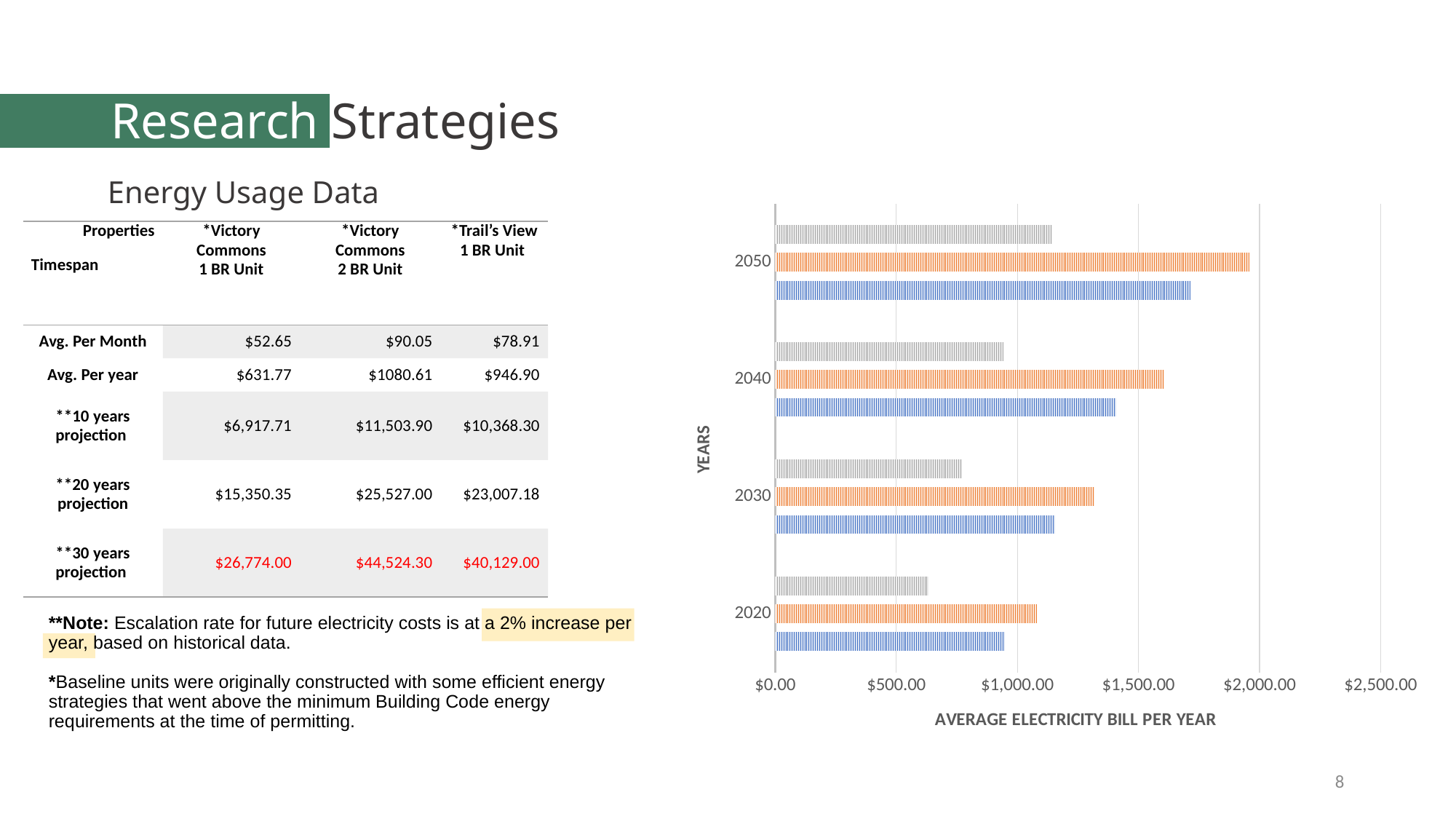
What kind of chart is shown on the right side of the slide? Bar chart What is the title of the vertical axis of the bar chart? YEARS In the bar chart, is the value of the orange bar for 2050 greater or less than $1,500.00? greater In the bar chart, which year has the longest orange bar? 2050 What is the title of the horizontal axis of the bar chart? AVERAGE ELECTRICITY BILL PER YEAR In the bar chart, do the bar lengths rise or fall as the years go from 2020 to 2050? Rise How many bars are plotted for each year in the bar chart? 3 How many years are shown on the vertical axis of the bar chart? 4 In the bar chart, is the value of the gray bar for 2020 greater or less than $1,000.00? less In the bar chart, for 2050, is the orange bar or the blue bar longer? Orange In the bar chart, which year has the shortest gray bar? 2020 In the bar chart, is the value of the orange bar for 2030 greater or less than $1,500.00? less